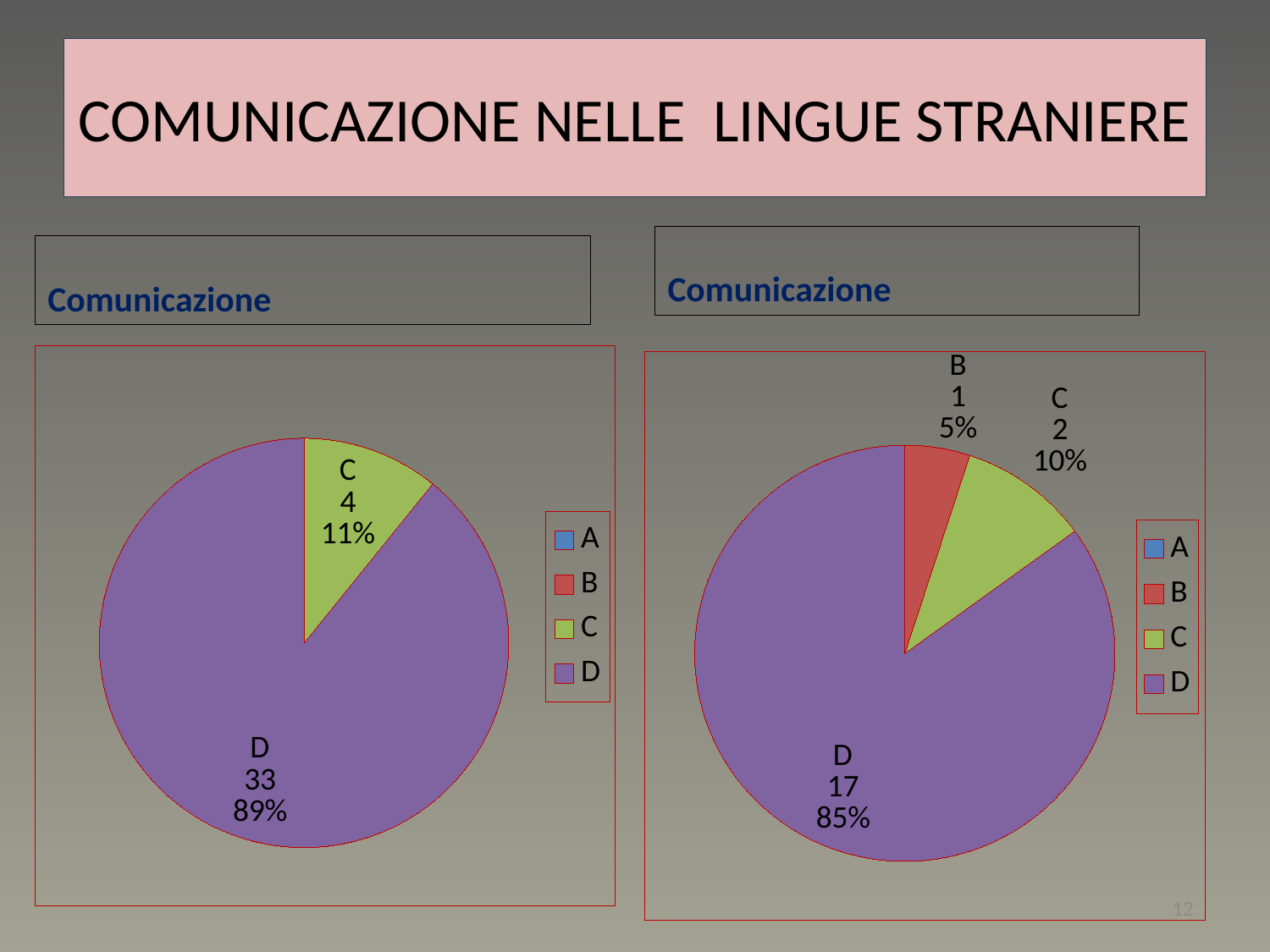
In the left pie chart, what is the difference between the values for D and C? 29 In the right pie chart, which is larger, the value for C or the value for B? C What type of chart is shown on the left side of the slide? Pie chart In the right pie chart, what is the value for category B? 1 How many entries does the legend of the right pie chart list? 4 In the left pie chart, what is the value for category D? 33 In the right pie chart, what percentage share does category D have? 85% In the right pie chart, which category has the largest slice? D In the right pie chart, what is the value for category C? 2 In the right pie chart, what is the total of the values for B, C and D? 20 In the left pie chart, what percentage share does category C have? 11% In the right pie chart, which labelled category has the smallest slice? B